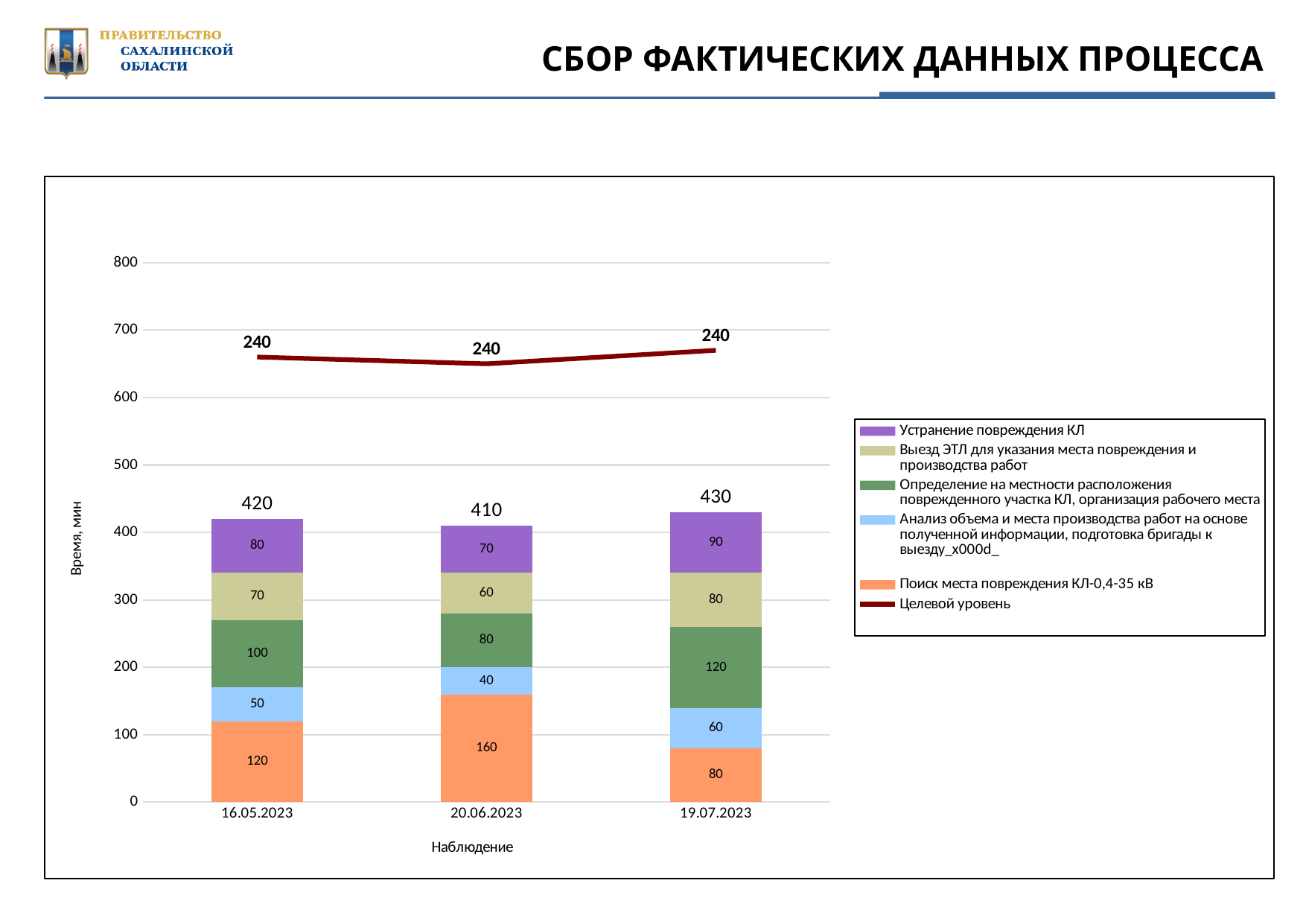
Which is larger: the 'Поиск места повреждения КЛ-0,4-35 кВ' value for 16.05.2023 or for 19.07.2023? 16.05.2023 Which observation date has the lowest stacked bar total? 20.06.2023 What is the labelled value of 'Целевой уровень' for 20.06.2023? 240 What is the value of 'Устранение повреждения КЛ' for 19.07.2023? 90 How many observation dates are shown on the x axis? 3 What is the difference between the stacked bar totals for 19.07.2023 and 20.06.2023? 20 Which observation date has the highest stacked bar total? 19.07.2023 What is the value of 'Определение на местности расположения поврежденного участка КЛ, организация рабочего места' for 16.05.2023? 100 What is the total of the stacked bar for 16.05.2023? 420 What is the value of 'Поиск места повреждения КЛ-0,4-35 кВ' for 20.06.2023? 160 What is the label of the y axis? Время, мин How many series does the legend list? 6